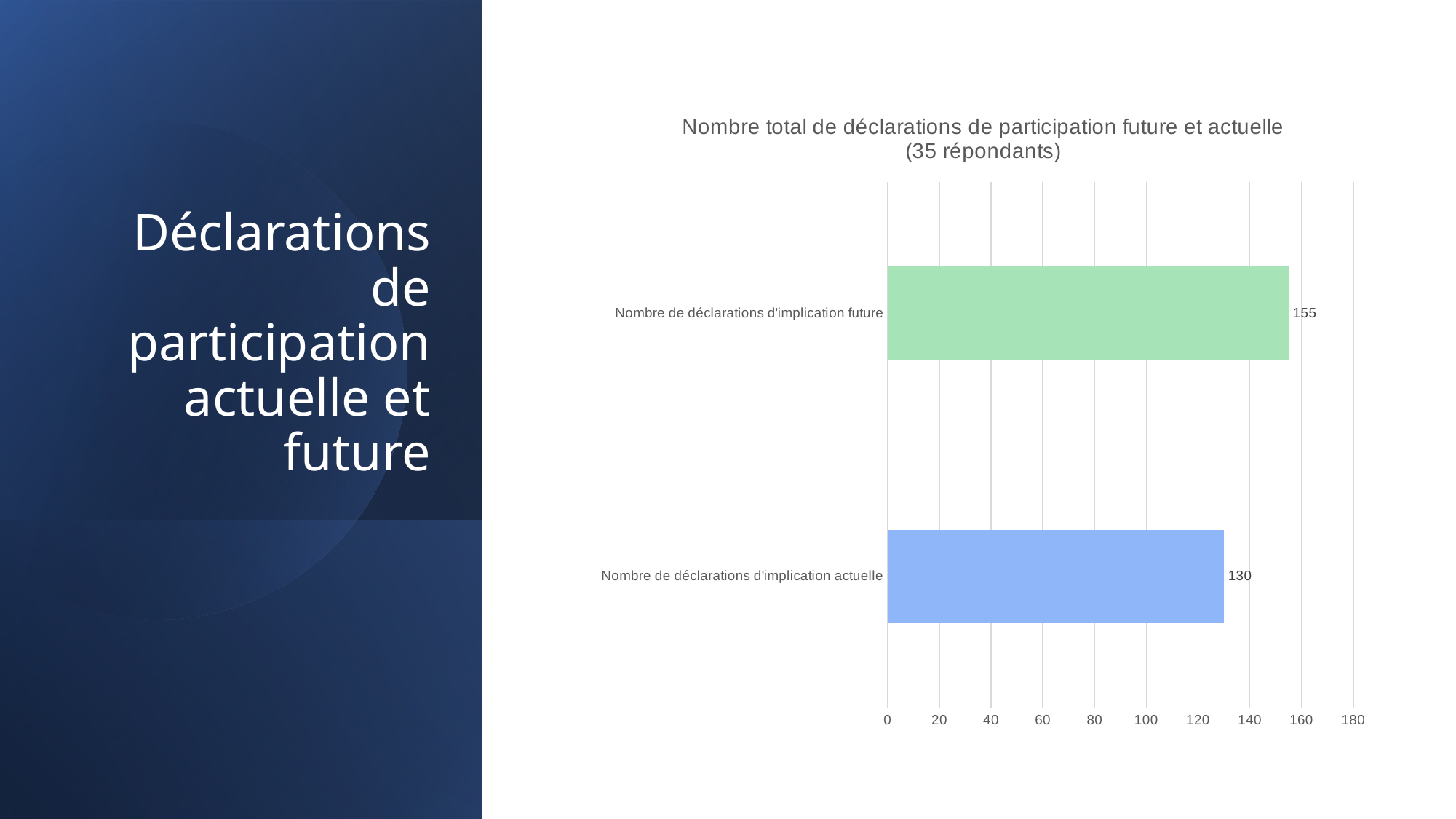
Which is larger: the value for 'implication future' or 'implication actuelle'? Nombre de déclarations d'implication future How many categories are shown in the chart? 2 What is the value for 'Nombre de déclarations d'implication future'? 155 What is the difference between the future and actuelle declaration counts? 25 What is the title of the chart? Nombre total de déclarations de participation future et actuelle (35 répondants) Is the value for 'Nombre de déclarations d'implication actuelle' greater or less than 140? less What is the maximum value shown on the horizontal axis? 180 What is the value for 'Nombre de déclarations d'implication actuelle'? 130 What kind of chart is shown on the slide? Bar chart Is the value for 'Nombre de déclarations d'implication future' greater or less than 140? greater Which category has the lowest value? Nombre de déclarations d'implication actuelle Which category has the highest value? Nombre de déclarations d'implication future